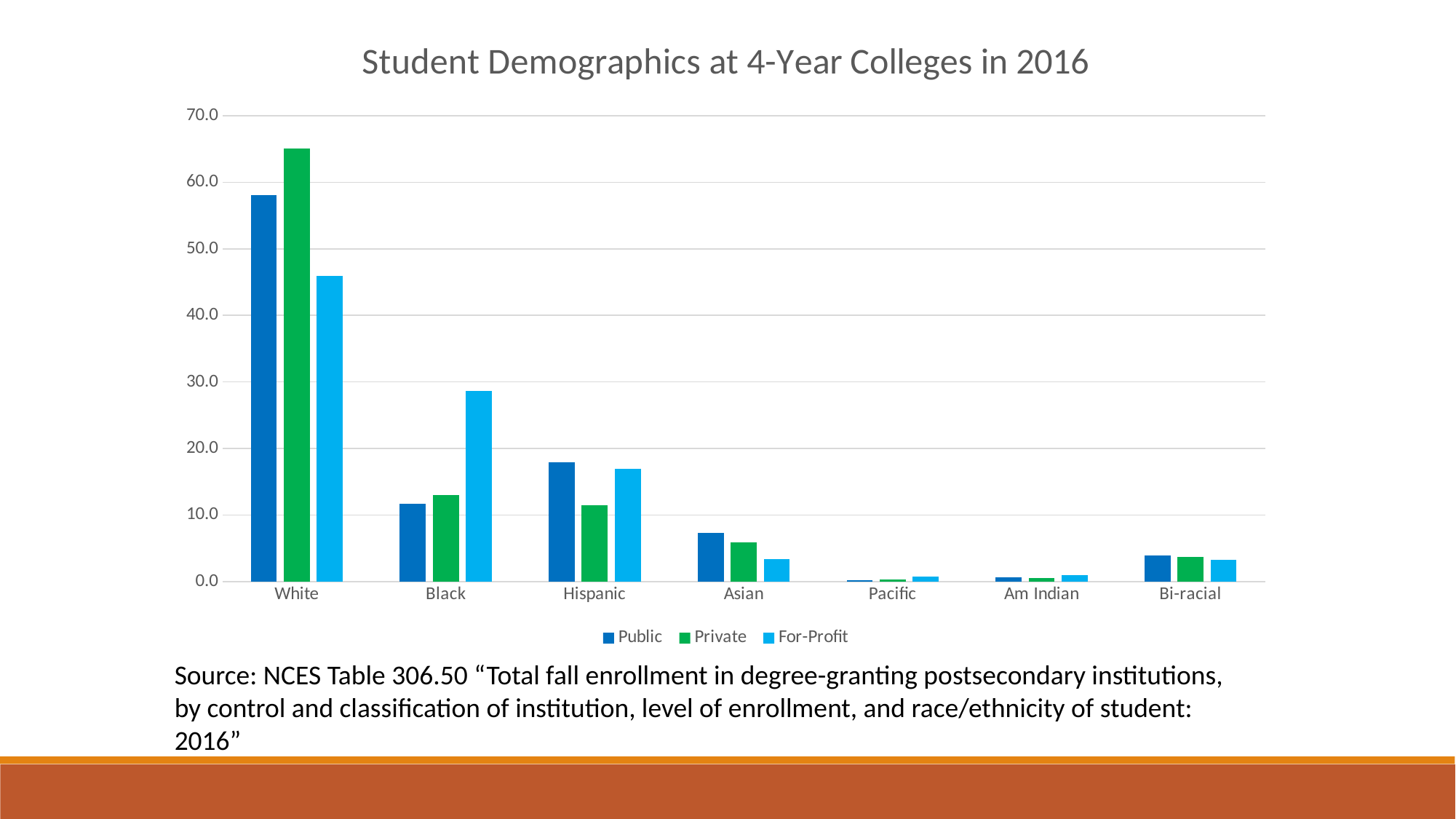
Is the For-Profit value for White greater or less than 50.0? less How many race/ethnicity categories are shown on the x axis? 7 Which category has the highest Private value? White For the Hispanic category, which is larger: the Public value or the Private value? Public For the White category, which series has the tallest bar? Private What type of chart is shown on the slide? bar chart Is the Private value for White greater or less than 60.0? greater Is the For-Profit value for Black greater or less than 20.0? greater How many series does the legend list? 3 For the Black category, which is larger: the Public value or the For-Profit value? For-Profit What is the title of the chart? Student Demographics at 4-Year Colleges in 2016